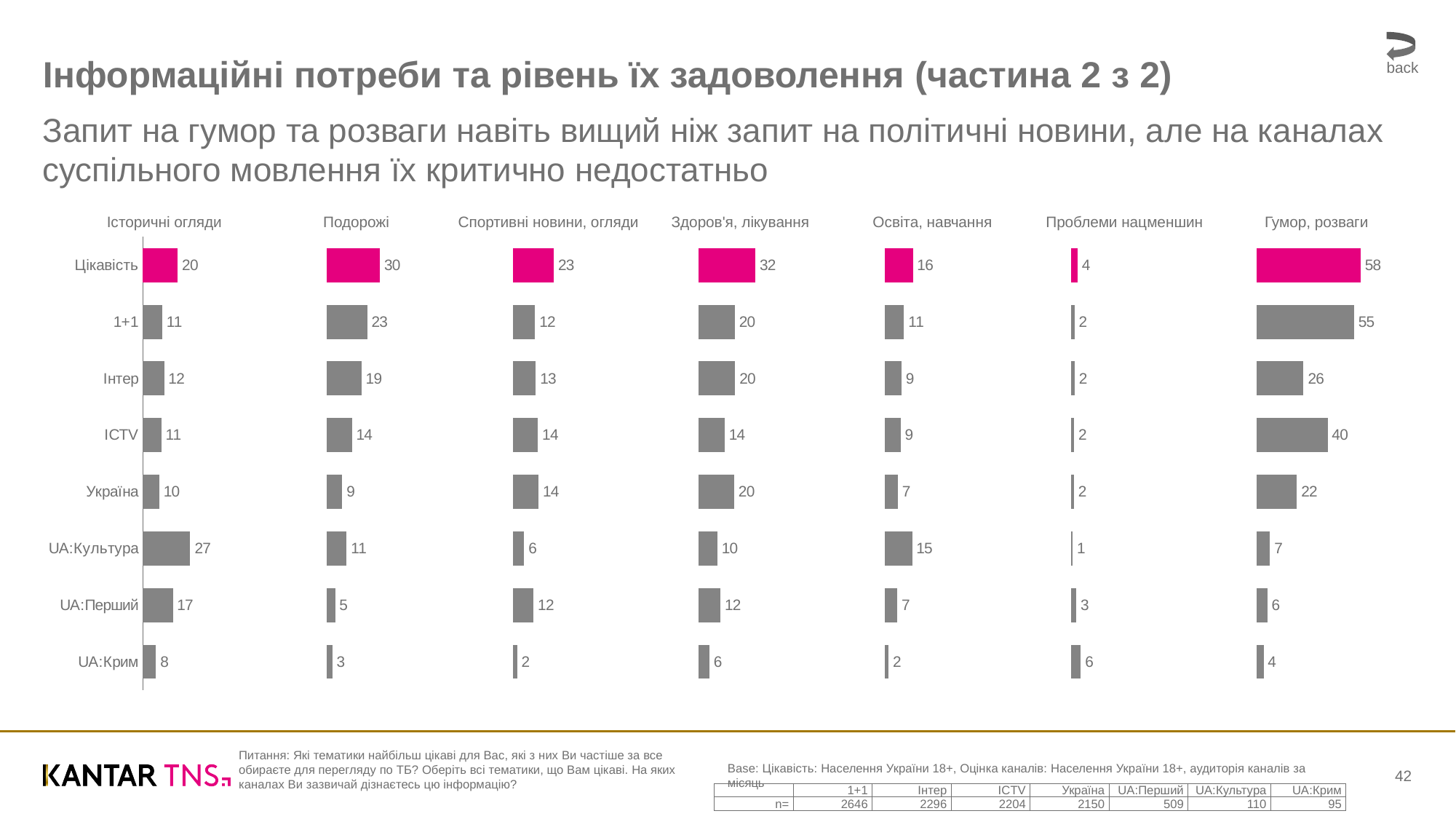
In the 'Проблеми нацменшин' chart, which category has the highest value? UA:Крим In the 'Спортивні новини, огляди' chart, which is larger: the value for Інтер or the value for UA:Культура? Інтер In the 'Гумор, розваги' chart, what is the value for Цікавість? 58 In the 'Здоров'я, лікування' chart, which category has the highest value? Цікавість How many separate charts are shown on the slide? 7 In the 'Гумор, розваги' chart, what is the difference between the values for ICTV and Україна? 18 In the 'Гумор, розваги' chart, what is the difference between the values for Цікавість and 1+1? 3 In the 'Освіта, навчання' chart, what is the value for UA:Культура? 15 What kind of chart is used on the slide? Bar chart How many categories (rows) does each chart on the slide show? 8 In the 'Подорожі' chart, which category has the lowest value? UA:Крим In the 'Історичні огляди' chart, what is the value for UA:Культура? 27